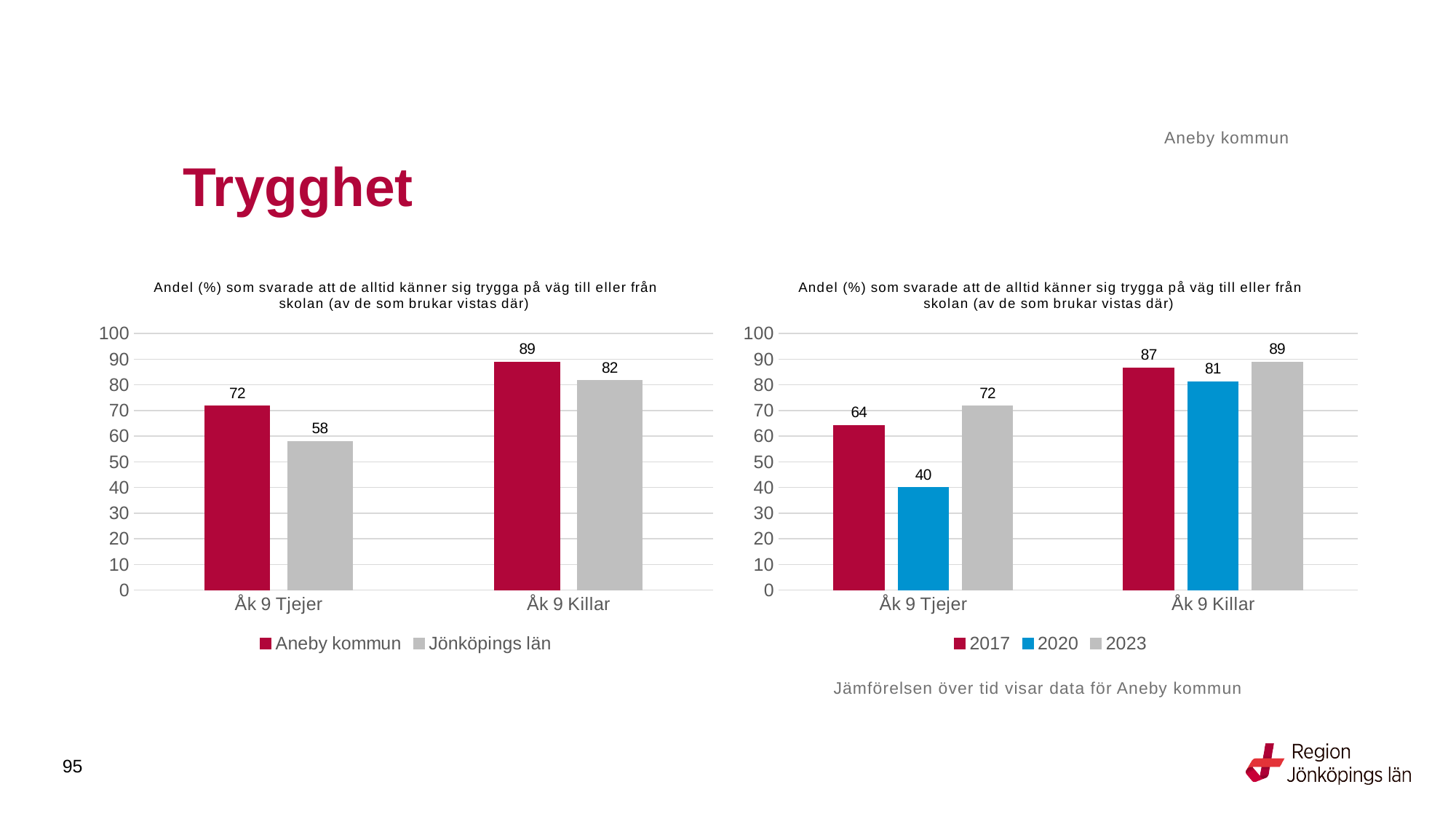
In the right chart, what is the value for 2020 for Åk 9 Tjejer? 40 In the right chart, what is the difference between the 2017 and 2023 values for Åk 9 Tjejer? 8 In the left chart, what is the value for Jönköpings län for Åk 9 Killar? 82 What kind of chart is the left chart? Bar chart In the right chart, which year has the highest value for Åk 9 Killar? 2023 In the left chart, which series has the higher value for Åk 9 Killar, Aneby kommun or Jönköpings län? Aneby kommun In the left chart, what is the difference between Aneby kommun and Jönköpings län for Åk 9 Tjejer? 14 In the right chart, how many series does the legend list? 3 In the left chart, how many series does the legend list? 2 In the right chart, what is the value for 2023 for Åk 9 Killar? 89 In the right chart, which year has the lowest value for Åk 9 Tjejer? 2020 In the left chart, what is the value for Aneby kommun for Åk 9 Tjejer? 72